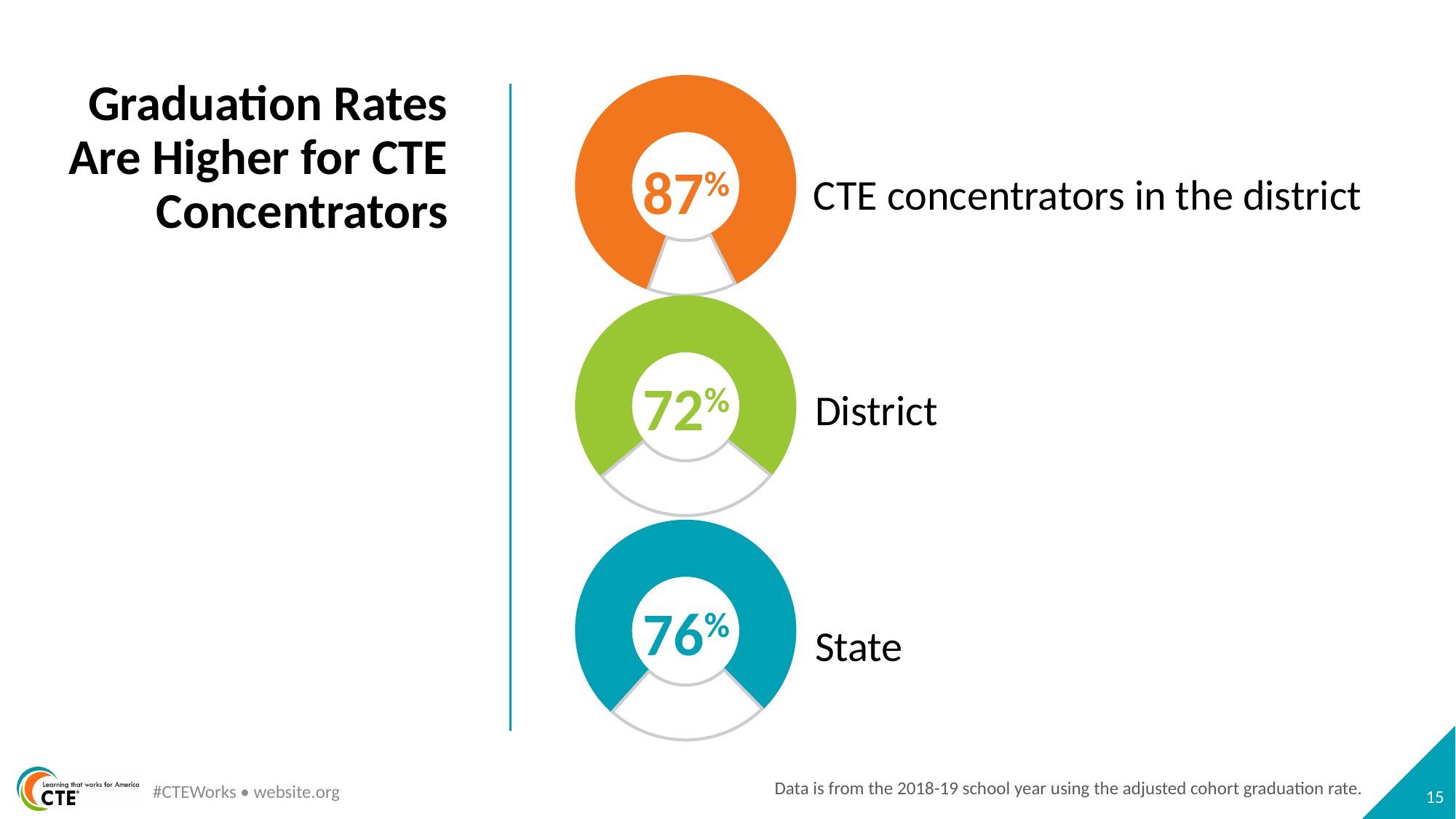
Which of the three groups has the lowest graduation rate? District What is the title of the slide? Graduation Rates Are Higher for CTE Concentrators How many percentage points higher is the graduation rate for CTE concentrators in the district than for the District? 15 Which of the three groups has the highest graduation rate? CTE concentrators in the district How many donut charts are shown on the slide? 3 What kind of chart is used to show each graduation rate? Donut chart What colour is the donut chart for the State? Teal What is the graduation rate shown for the State? 76% What is the graduation rate shown for CTE concentrators in the district? 87% What is the difference between the State graduation rate and the District graduation rate? 4 Which has a higher graduation rate, the State or the District? State What is the graduation rate shown for the District? 72%